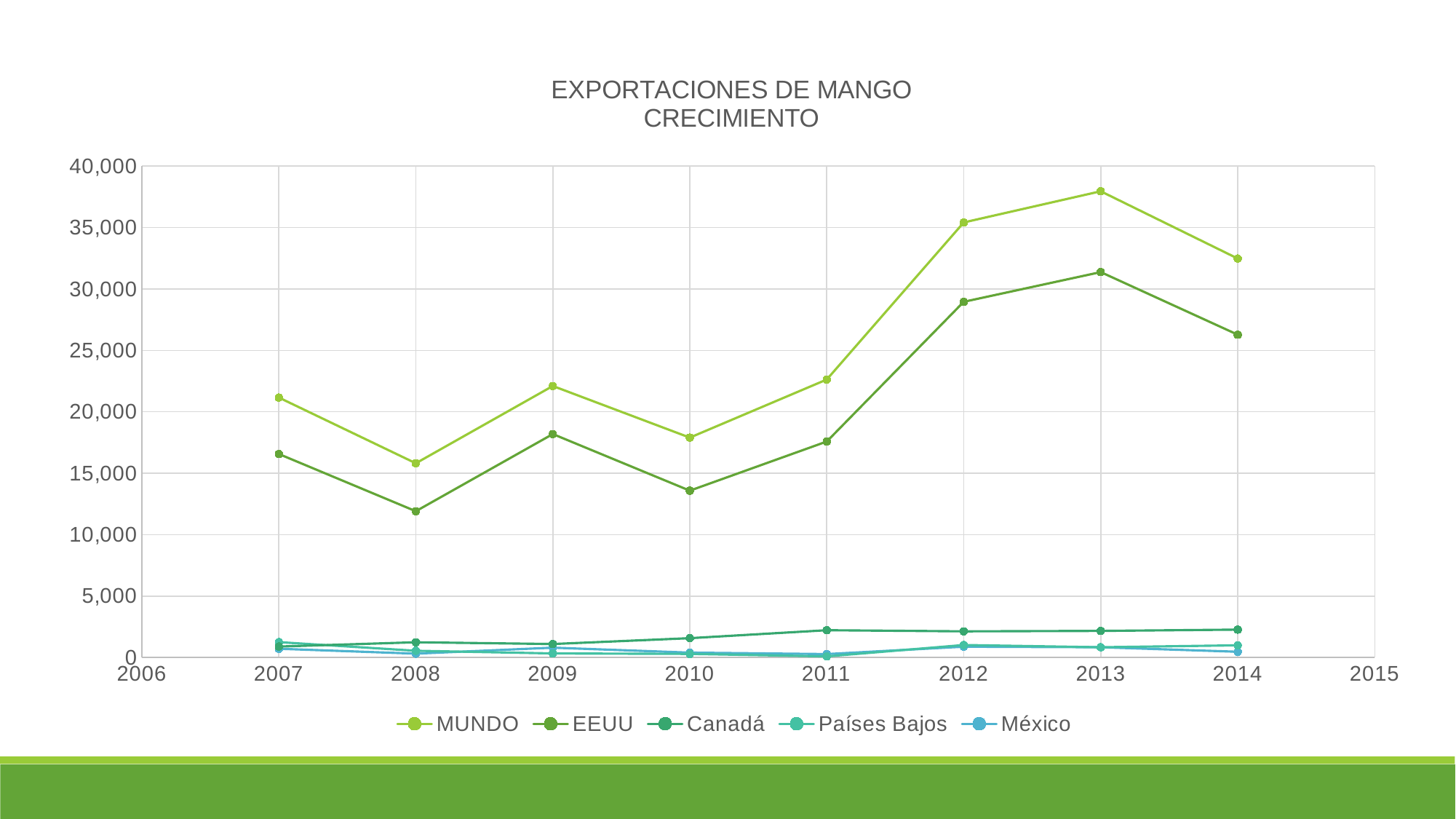
Does the MUNDO series rise or fall from 2011 to 2013? rise In which year does the EEUU series reach its lowest value? 2008 Which series has the larger value in 2013, MUNDO or EEUU? MUNDO How many series does the legend list? 5 What kind of chart is shown on the slide? line chart Is the value for EEUU in 2008 greater or less than 15,000? less In which year does the MUNDO series reach its highest value? 2013 Is the value for EEUU in 2014 greater or less than 25,000? greater How many years have plotted data points for the MUNDO series? 8 Is the value for MUNDO in 2013 greater or less than 35,000? greater Which series has the larger value in 2014, Canadá or México? Canadá What is the title of the chart? EXPORTACIONES DE MANGO CRECIMIENTO